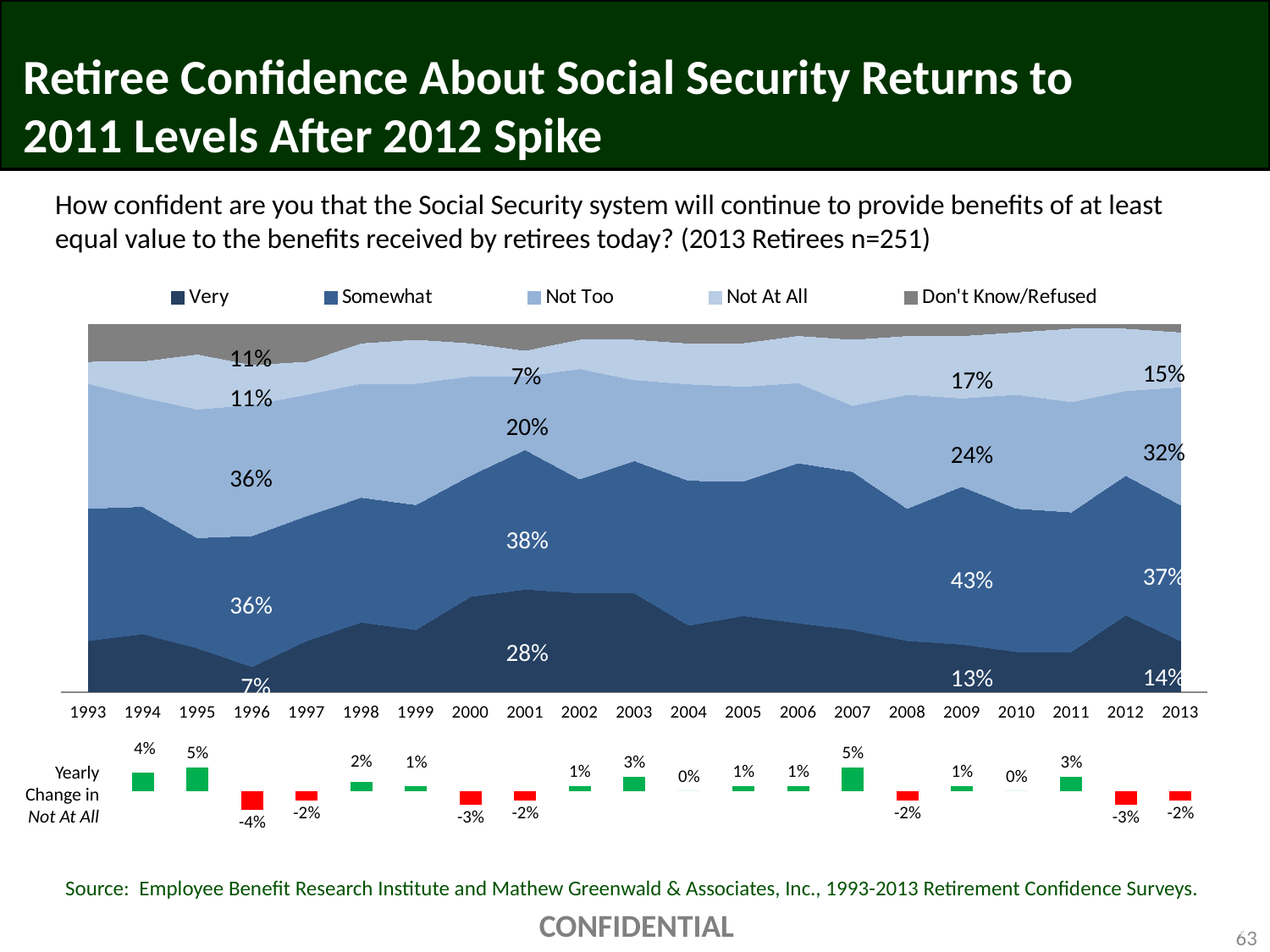
In the main stacked area chart, what was the "Don't Know/Refused" value in 1996? 11% In the main stacked area chart, what percentage of retirees were "Very" confident in 2013? 14% In the main stacked area chart, by how many percentage points did the "Somewhat" value change from 2009 to 2013? 6 percentage points lower How many years are shown on the x axis of the main stacked area chart? 21 What kind of chart is the main chart showing confidence levels from 1993 to 2013? Stacked area chart In the lower "Yearly Change in Not At All" chart, what is the value for 2007? 5% How many series does the legend of the main chart list? 5 In the lower "Yearly Change in Not At All" chart, which year has the lowest value? 1996 What kind of chart is the lower chart labelled "Yearly Change in Not At All"? Bar chart In the main stacked area chart, what was the "Not At All" value in 2001? 7% In the main stacked area chart, which is larger: the "Not Too" value in 2013 or in 2009? 2013 In the main stacked area chart, what percentage of retirees were "Somewhat" confident in 2009? 43%